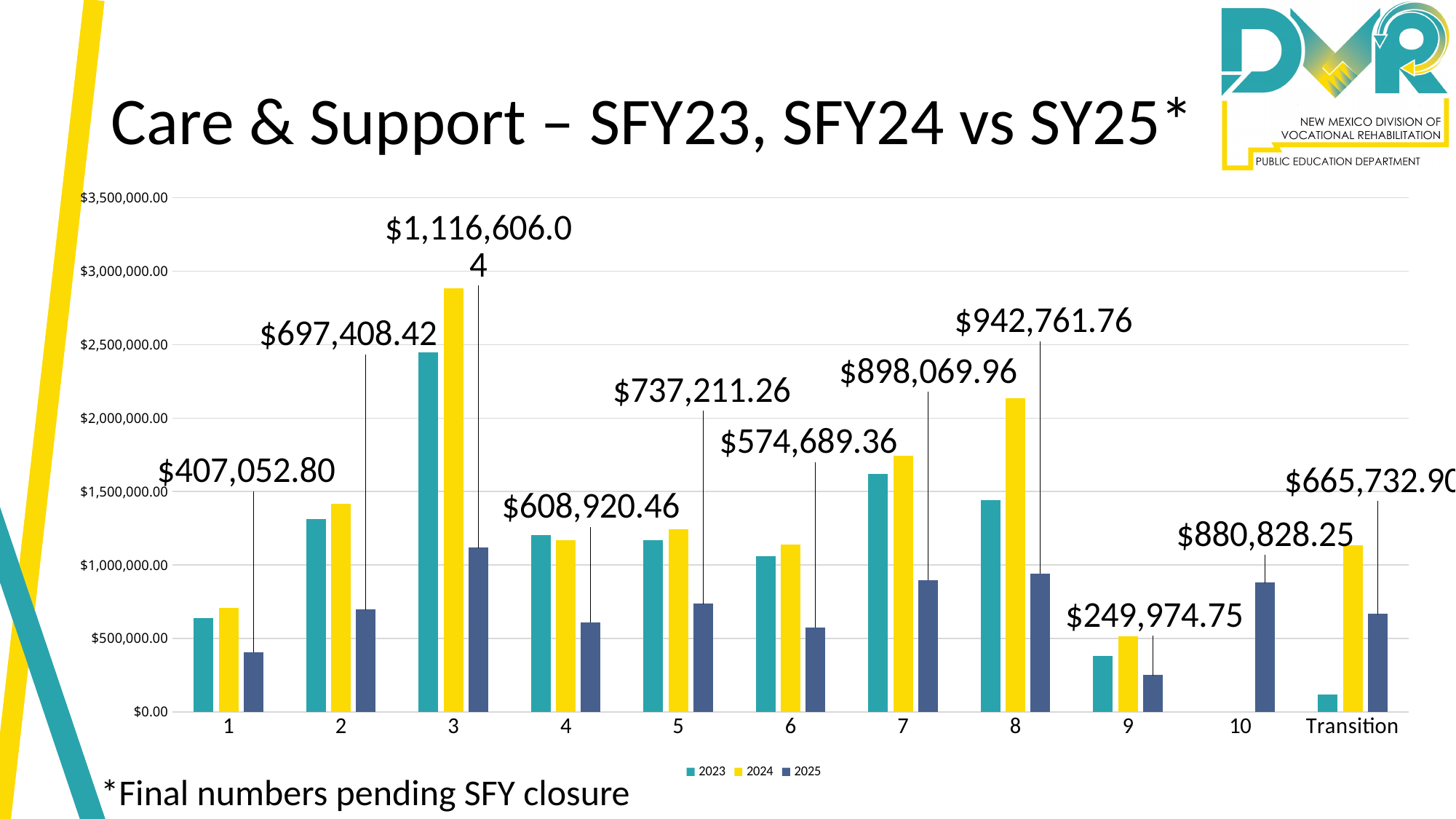
Which has the larger 2025 value, category 5 or category 6? 5 What is the difference between the 2025 values for category 8 and category 7? $44,691.80 How many categories are shown on the x axis? 11 What is the 2025 value for category 9? $249,974.75 What kind of chart is shown on the slide? bar chart How many series does the legend list? 3 Which category has the lowest 2025 value? 9 Is the 2024 value for category 3 greater or less than $2,500,000.00? greater What is the 2025 value for category 10? $880,828.25 Which category has the highest 2025 value? 3 What is the 2025 value for category 3? $1,116,606.04 Is the 2023 value for category 1 greater or less than $1,000,000.00? less